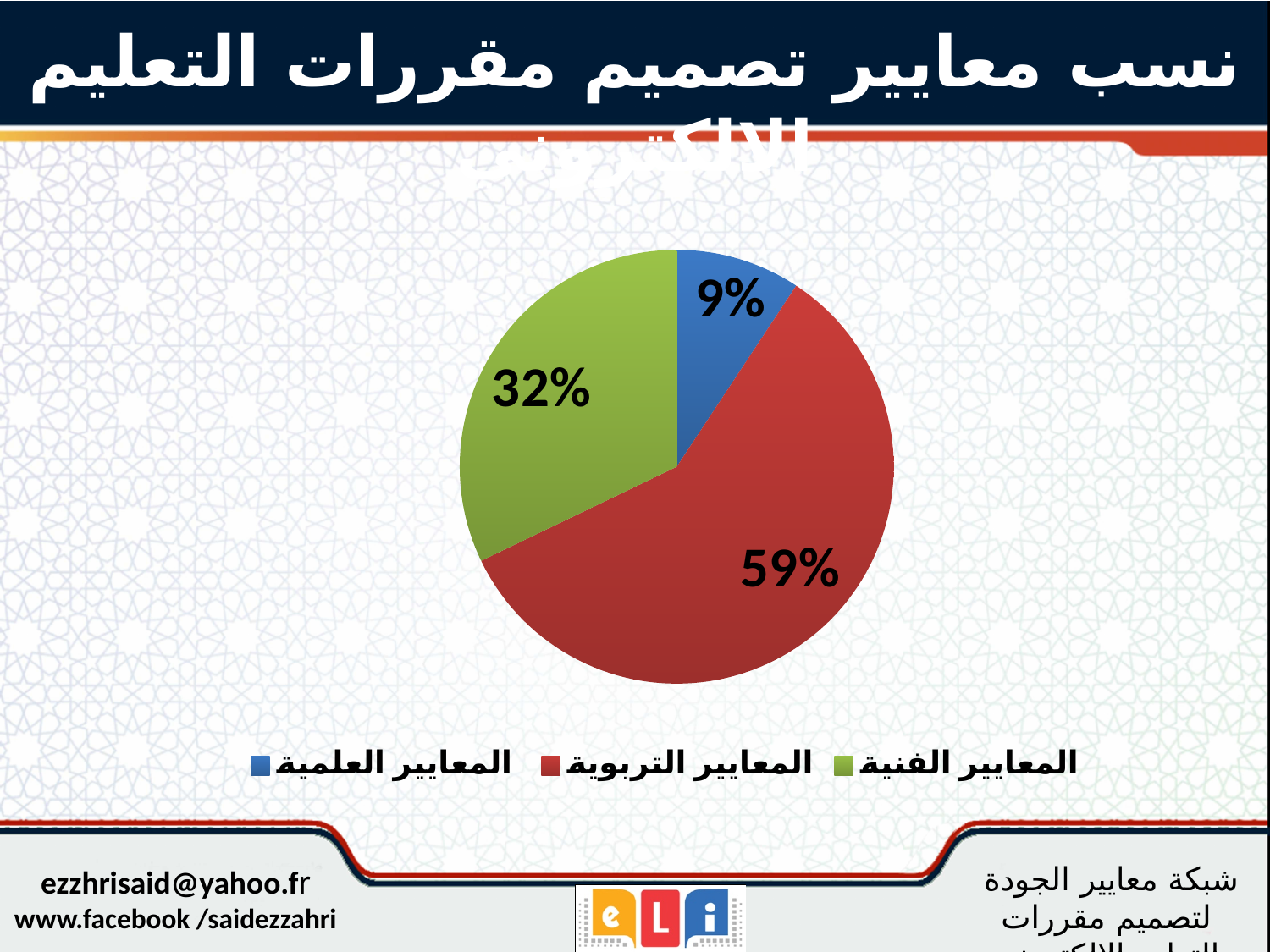
What is the difference in percentage points between المعايير التربوية and المعايير الفنية? 27 What share of the pie does المعايير التربوية have? 59% Which category has the largest slice of the pie? المعايير التربوية What colour is the slice for المعايير التربوية? Red Which is larger, the slice for المعايير الفنية or the slice for المعايير العلمية? المعايير الفنية How many slices does the pie chart have? 3 What is the difference in percentage points between المعايير الفنية and المعايير العلمية? 23 Which category has the smallest slice of the pie? المعايير العلمية What share of the pie does المعايير العلمية have? 9% What kind of chart is shown on the slide? Pie chart What share of the pie does المعايير الفنية have? 32% How many entries does the legend list? 3